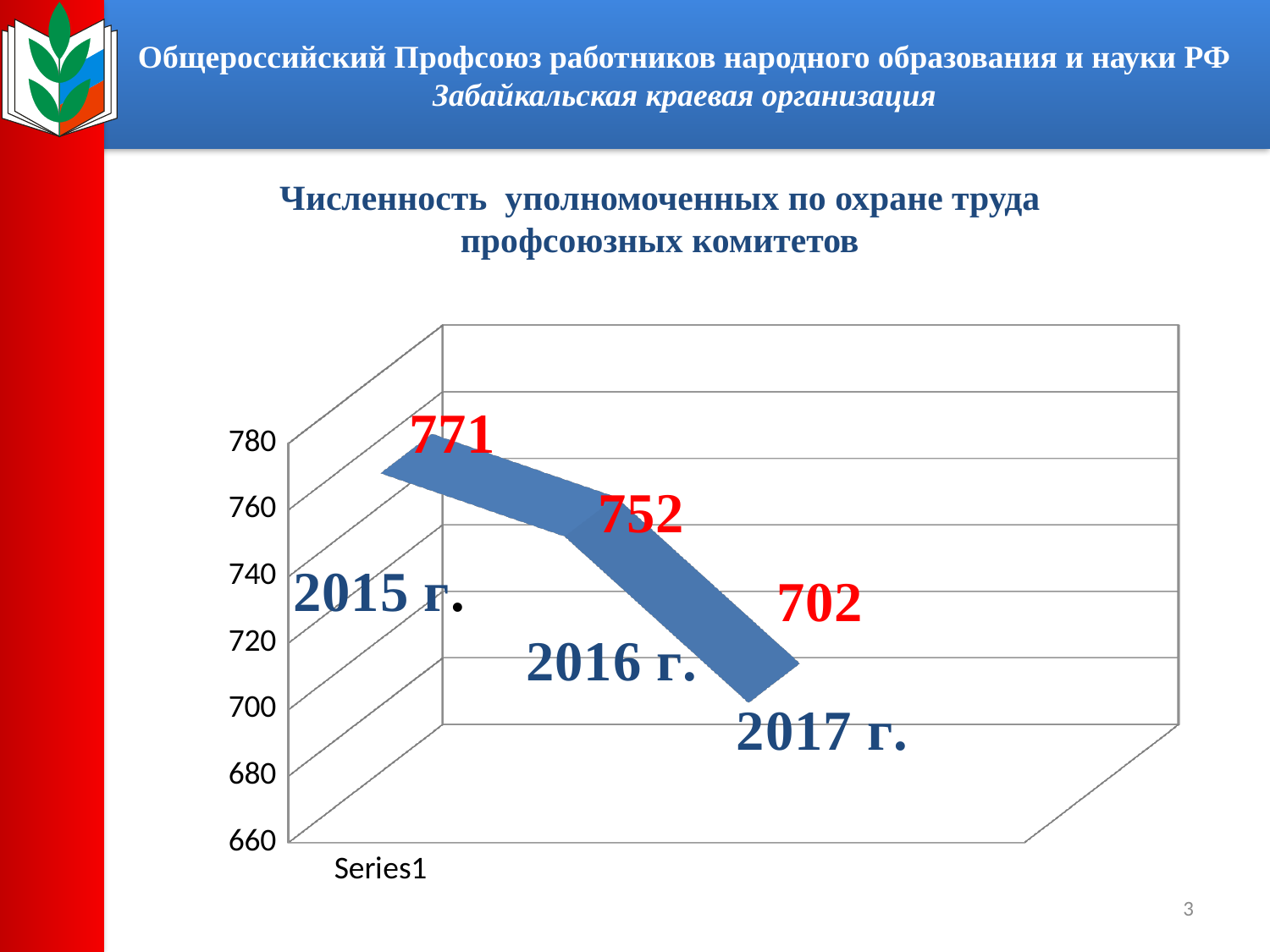
Which is larger, the value for 2015 г. or the value for 2016 г.? 2015 г. How many years are plotted on the chart? 3 What is the difference between the values for 2015 г. and 2017 г.? 69 Which year has the highest value? 2015 г. Do the values rise or fall from 2015 г. to 2017 г.? fall Which year has the lowest value? 2017 г. Is the value for 2017 г. greater or less than 720? less What kind of chart is shown on the slide? line chart What is the value for 2017 г.? 702 What is the difference between the values for 2016 г. and 2017 г.? 50 What is the value for 2016 г.? 752 What is the value for 2015 г.? 771